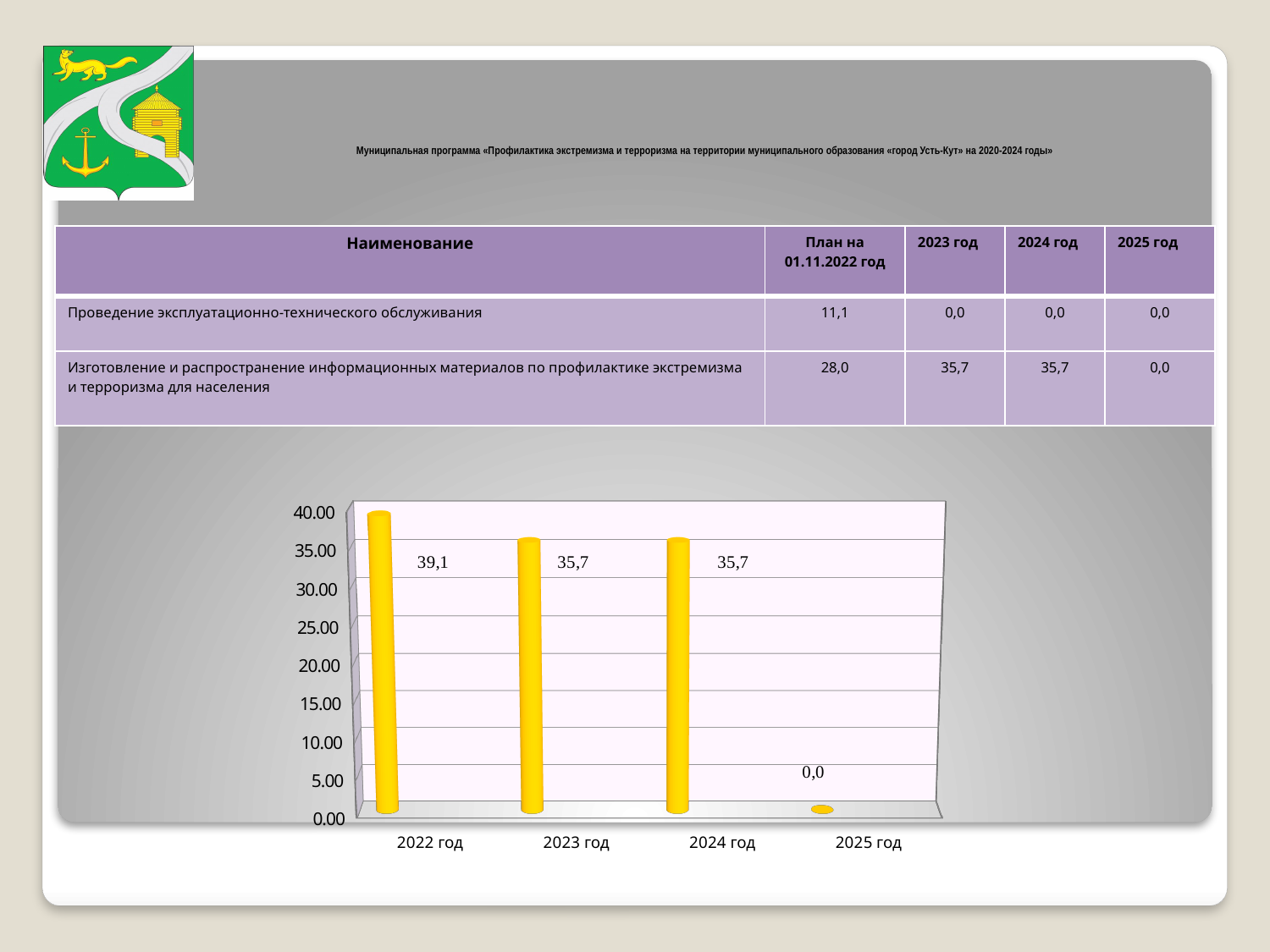
Which year has the highest value in the chart? 2022 год What is the value for 2022 год in the chart? 39,1 What is the value for 2025 год in the chart? 0,0 Is the value for 2023 год greater or less than 30.00? greater How many categories are shown on the x axis of the chart? 4 What is the value for 2024 год in the chart? 35,7 Which is larger, the value for 2022 год or the value for 2024 год? 2022 год Which year has the lowest value in the chart? 2025 год Do the values rise or fall from 2022 год to 2025 год? fall What is the value for 2023 год in the chart? 35,7 What is the difference between the values for 2022 год and 2023 год? 3,4 What kind of chart is shown on the slide? bar chart